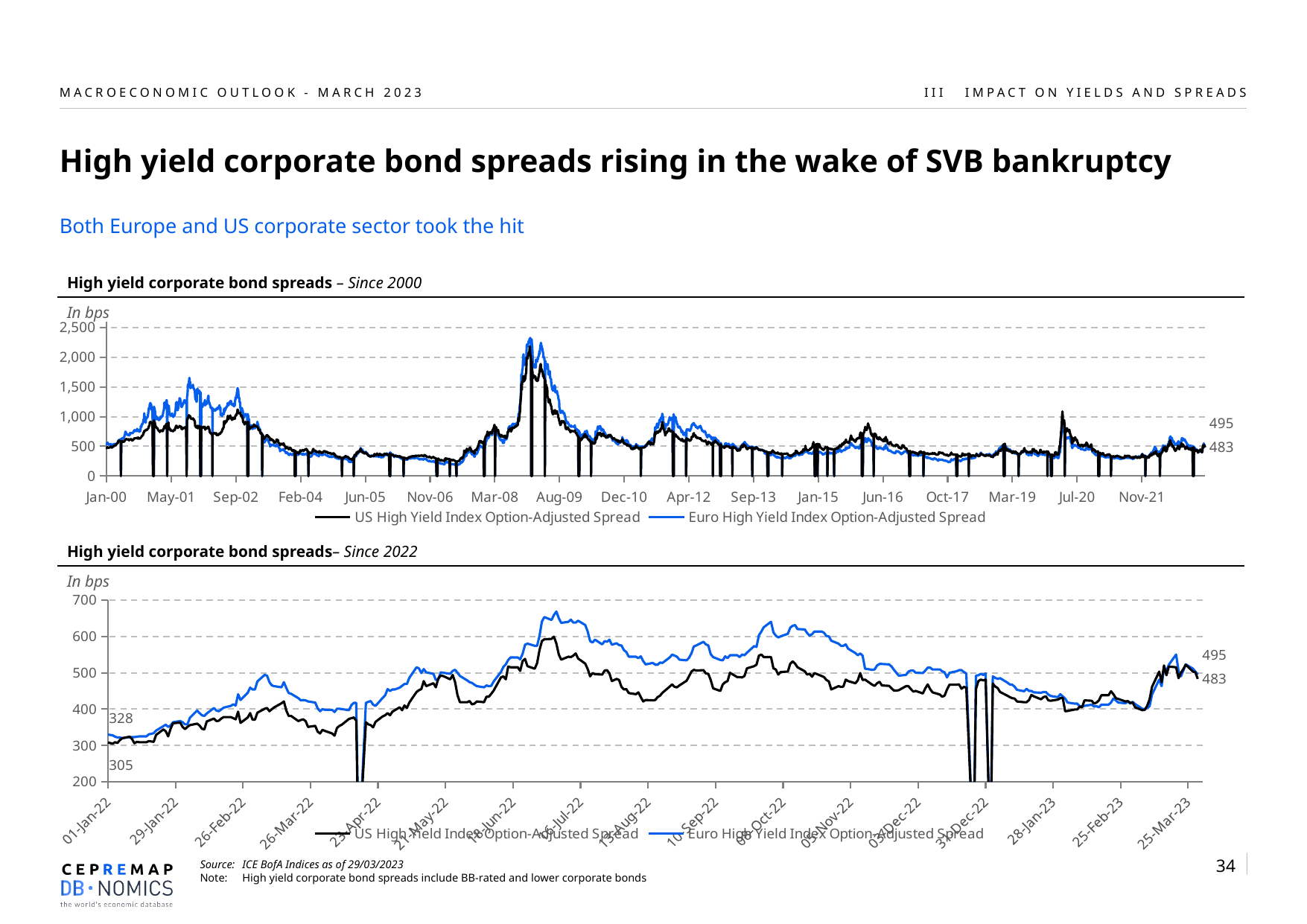
In the 'Since 2022' chart, what is the US High Yield Index Option-Adjusted Spread value labelled at 01-Jan-22? 305 In the 'Since 2022' chart, what is the latest value labelled for the Euro High Yield Index Option-Adjusted Spread? 495 In the 'Since 2000' chart, is the peak of the Euro High Yield Index Option-Adjusted Spread around 2008-2009 greater or less than 2,000? greater In the 'Since 2022' chart, what is the difference between the Euro and US spread values labelled at 01-Jan-22? 23 What kind of chart is the 'High yield corporate bond spreads – Since 2000' chart? line chart In what unit are the values on both charts expressed? In bps In the 'Since 2022' chart, is the Euro High Yield Index Option-Adjusted Spread in early October 2022 greater or less than 600? greater In the 'Since 2022' chart, what is the latest value labelled for the US High Yield Index Option-Adjusted Spread? 483 In the 'Since 2022' chart, what is the Euro High Yield Index Option-Adjusted Spread value labelled at 01-Jan-22? 328 How many series does the legend of the 'Since 2022' chart list? 2 In the 'Since 2022' chart, what is the difference between the two latest values labelled at the right end (495 and 483)? 12 In the 'Since 2022' chart, which series is higher at 01-Jan-22, the US or the Euro spread? Euro High Yield Index Option-Adjusted Spread